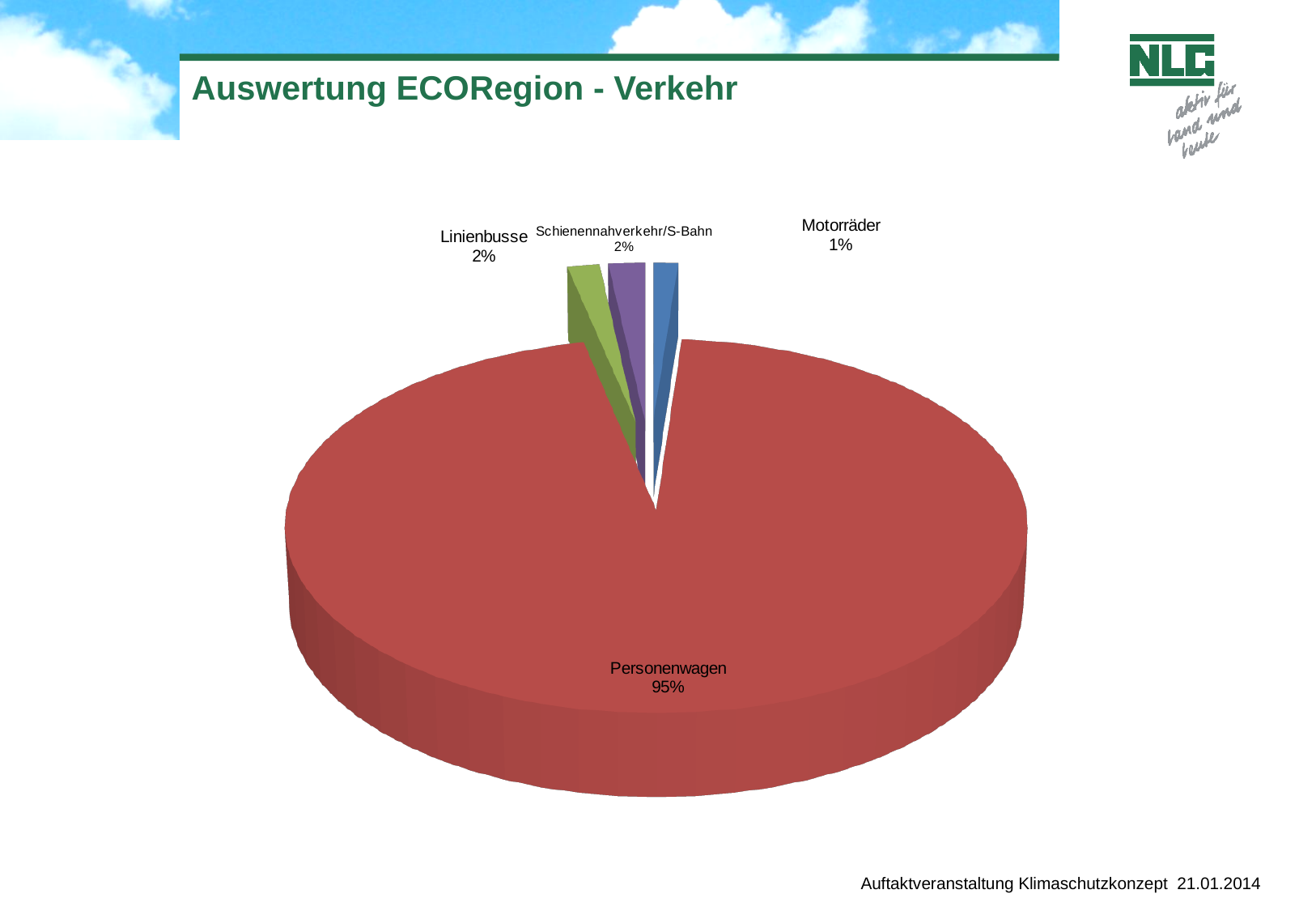
What share of the pie does Linienbusse account for? 2% What share of the pie does Schienennahverkehr/S-Bahn account for? 2% What is the difference in percentage points between Personenwagen and Linienbusse? 93 What share of the pie does Personenwagen account for? 95% What is the title of the slide containing the chart? Auswertung ECORegion - Verkehr What kind of chart is shown on the slide? Pie chart Which category has the largest slice of the pie? Personenwagen Which category has the smallest slice of the pie? Motorräder How many categories are shown in the pie chart? 4 Which is larger, the share for Linienbusse or the share for Motorräder? Linienbusse What colour is the Personenwagen slice? Red